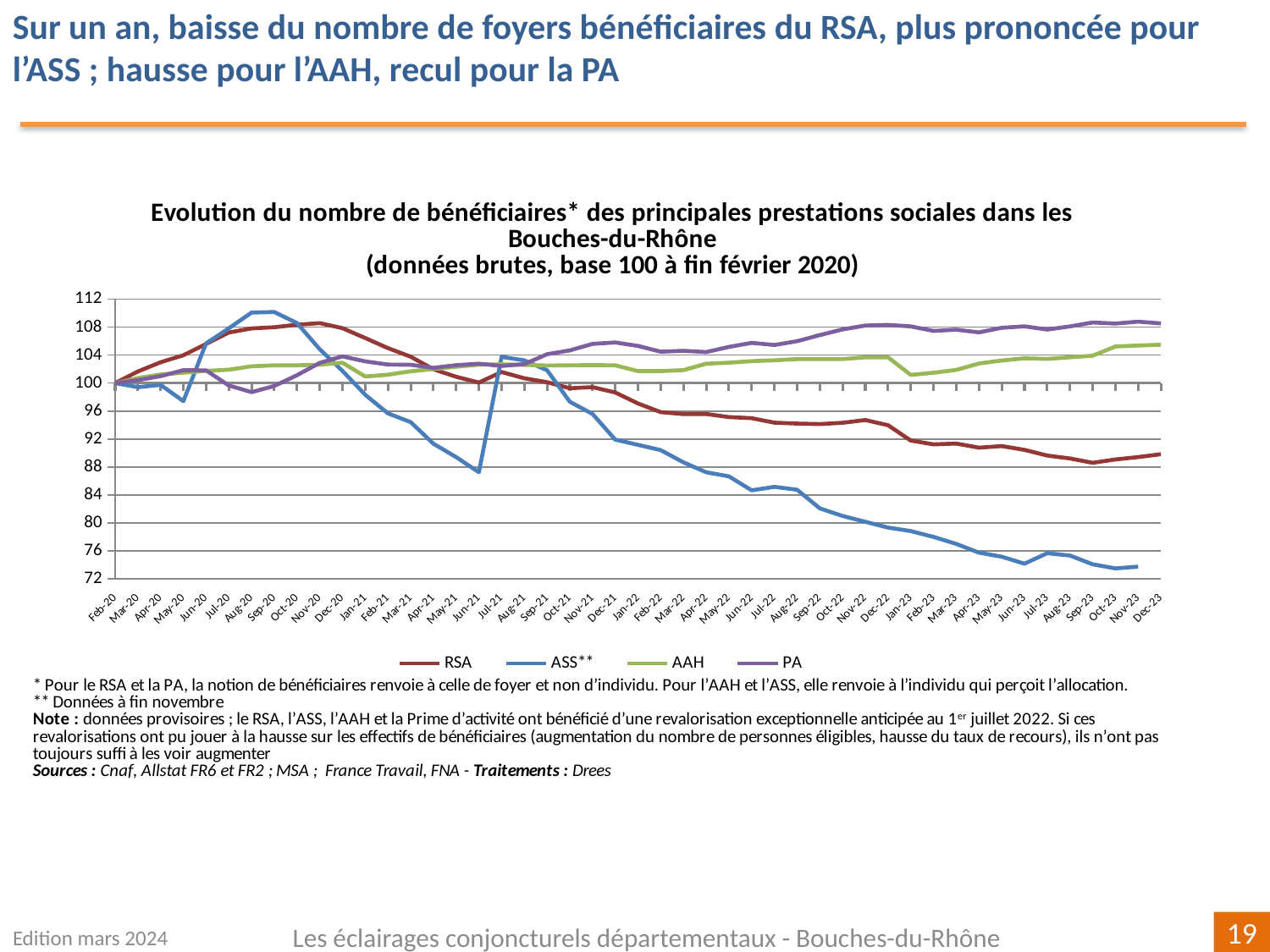
At Dec-23, which is larger, the value for RSA or the value for AAH? AAH Is the value for ASS** at Sep-20 greater or less than 108? greater What is the value of all four series at Feb-20, the base month? 100 Does the ASS** series rise or fall between Jul-21 and Dec-23? Fall How many series does the legend list? 4 Which series has the highest value at Dec-23? PA What kind of chart is shown on the slide? Line chart Is the value for RSA at Dec-23 greater or less than 88? greater Which series are listed in the legend? RSA, ASS**, AAH, PA Is the value for PA at Dec-23 greater or less than 104? greater Which series has the lowest value at Dec-23? RSA